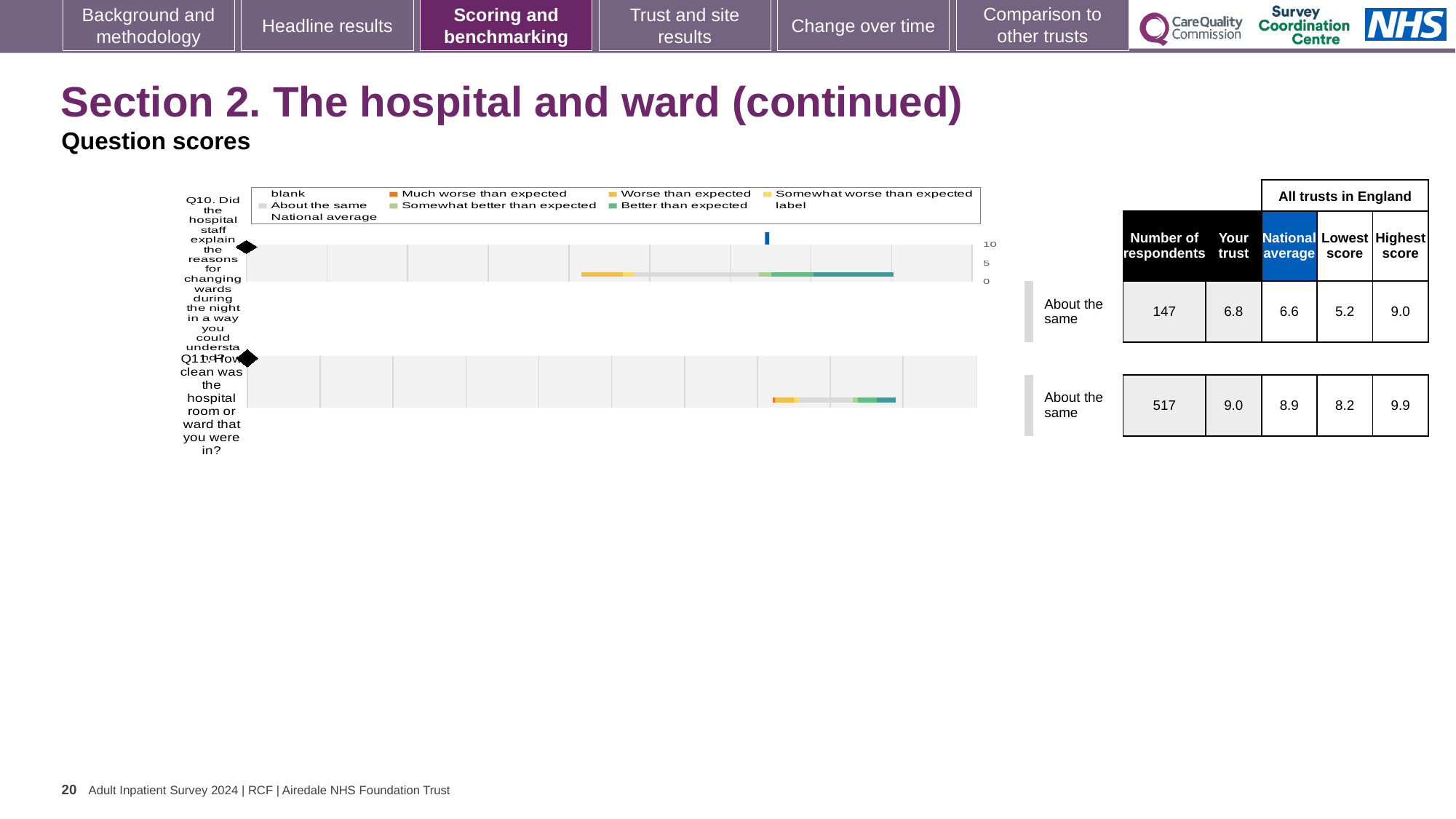
Which question is the top chart about? Q10. Did the hospital staff explain the reasons for changing wards during the night in a way you could understand? For Q10, what is the difference between the 'Your trust' score and the national average? 0.2 What kind of chart is used to show the question scores for Q10 and Q11? Bar chart What is the highest tick value shown on the score axis of the Q10 chart? 10 How many survey questions have a chart on this slide? 2 For Q11, which is larger: the 'Your trust' score or the national average? Your trust According to the table, how many respondents answered Q11? 517 For Q11, what is the difference between the highest score and the lowest score across all trusts in England? 1.7 What benchmark category is shown next to the Q10 chart? About the same According to the table, what is the 'Your trust' score for Q10? 6.8 Which question has the higher 'Your trust' score, Q10 or Q11? Q11 According to the table, what is the national average score for Q11? 8.9